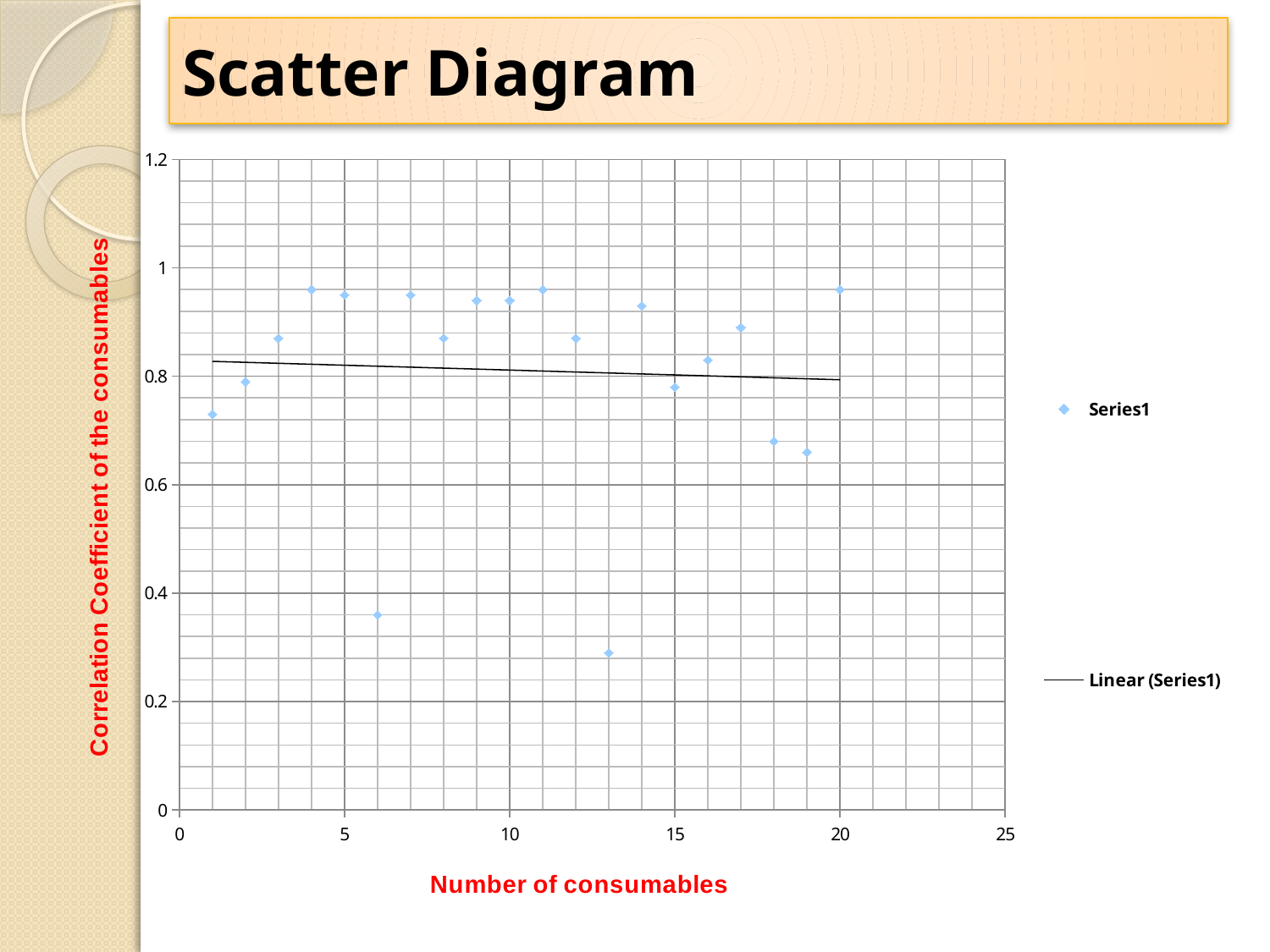
At which number of consumables is the lowest correlation coefficient plotted? 13 Which has the larger correlation coefficient, 6 consumables or 13 consumables? 6 consumables How many entries does the legend list? 2 What is the title of the chart slide? Scatter Diagram How many data points are plotted in Series1? 20 Is the value for 4 consumables greater or less than 0.8? greater Is the value for 6 consumables greater or less than 0.4? less What kind of chart is shown on the slide? Scatter chart What is the label of the x axis? Number of consumables Is the value for 19 consumables greater or less than 0.8? less Does the linear trendline rise or fall as the number of consumables increases? fall